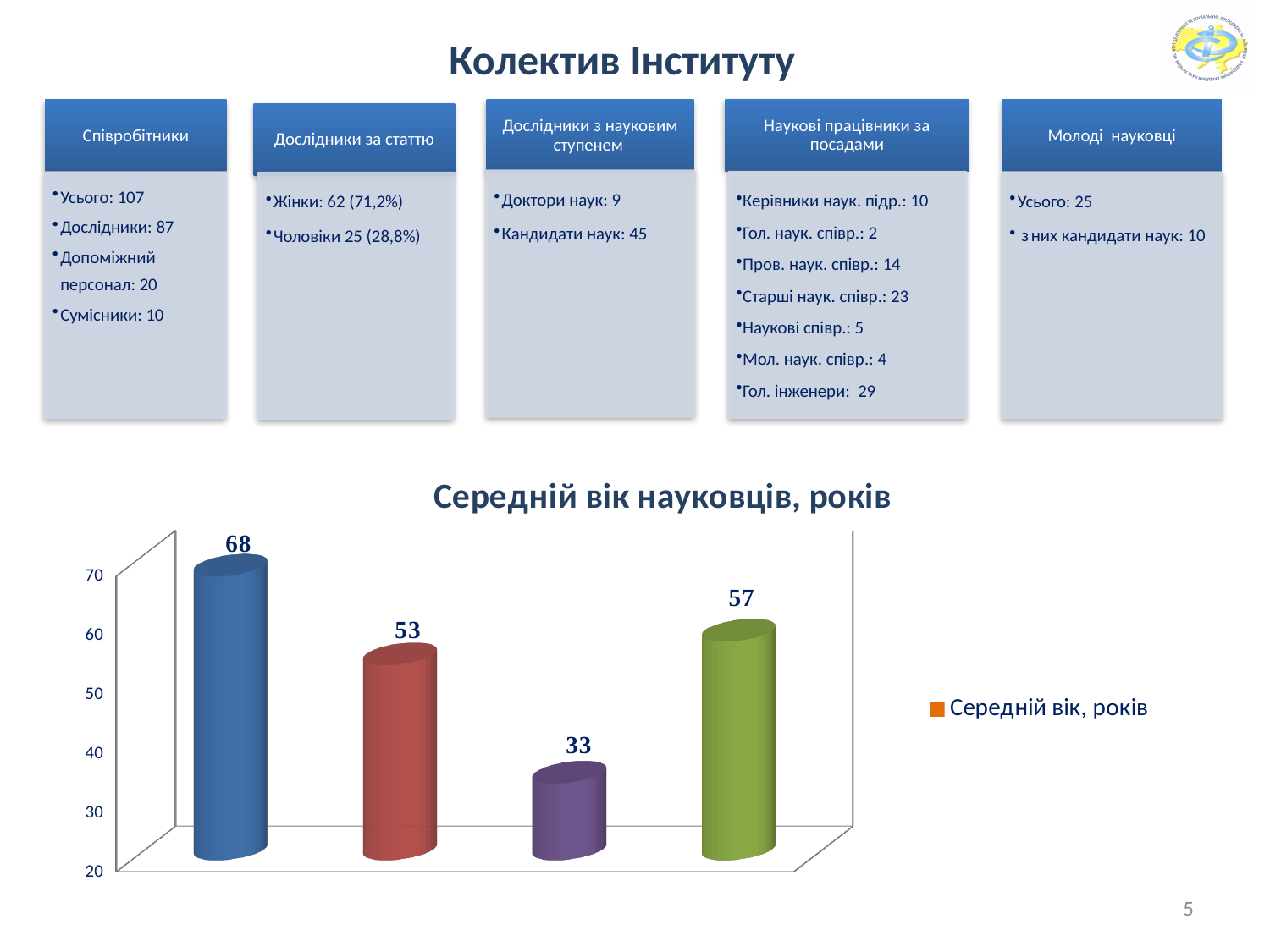
Which bar in the chart has the lowest value? the third (purple) bar, 33 Which is larger: the value of the red bar or the value of the green bar? the green bar (57) What is the value shown on the second (red) bar of the chart? 53 What is the title of the chart on the slide? Середній вік науковців, років Which bar in the chart has the highest value? the leftmost (blue) bar, 68 What is the difference between the values of the leftmost (blue) bar and the third (purple) bar? 35 What is the value shown on the third (purple) bar of the chart? 33 What is the value shown on the rightmost (green) bar of the chart? 57 What type of chart is shown under the title "Середній вік науковців, років"? bar chart How many series does the chart legend list? 1 What is the value shown on the leftmost (blue) bar of the chart? 68 How many bars are plotted in the chart? 4